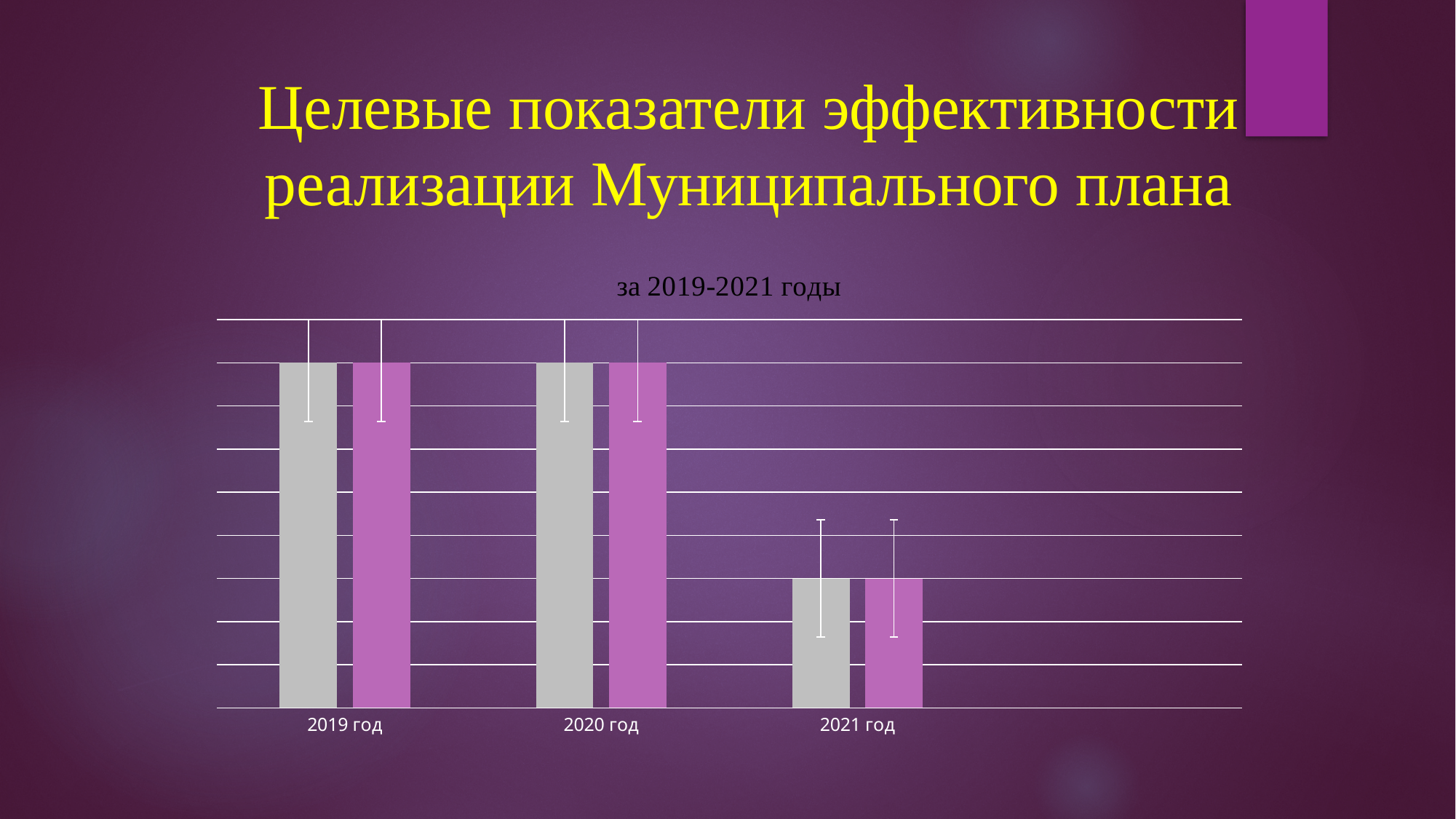
What is the label of the first category on the x axis? 2019 год What two colours are used for the bars in the chart? grey and pink What is the title printed above the chart? за 2019-2021 годы How many year categories are shown on the x axis of the chart? 3 Do the bar values rise or fall from 2020 год to 2021 год? fall Which year has the larger pink bar, 2020 год or 2021 год? 2020 год Which year has the larger grey bar, 2019 год or 2021 год? 2019 год What is the label of the last category on the x axis? 2021 год What kind of chart is shown on the slide? bar chart How many bars are plotted for each year category in the chart? 2 Which year has the lowest bars in the chart? 2021 год